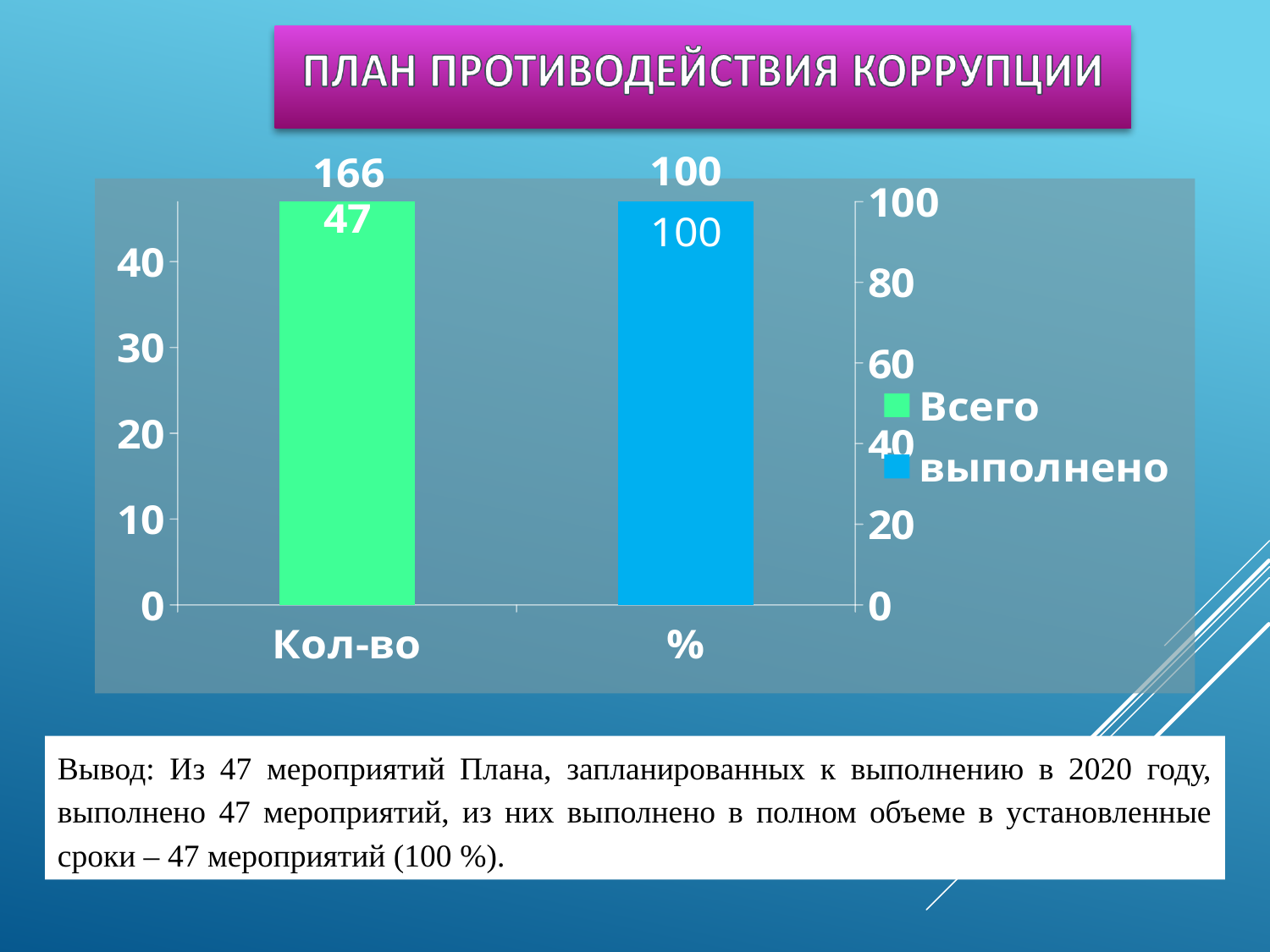
What value is printed inside the green bar for Кол-во? 47 What are the two category labels on the x axis? Кол-во and % What is the highest tick shown on the right-hand axis? 100 Is the value for % on the right axis greater or less than 80? greater Which legend entry is shown in green? Всего What kind of chart is shown on the slide? bar chart Is the value for Кол-во on the left axis greater or less than 40? greater How many entries does the legend list? 2 How many bars are plotted in the chart? 2 What value is printed inside the blue bar for %? 100